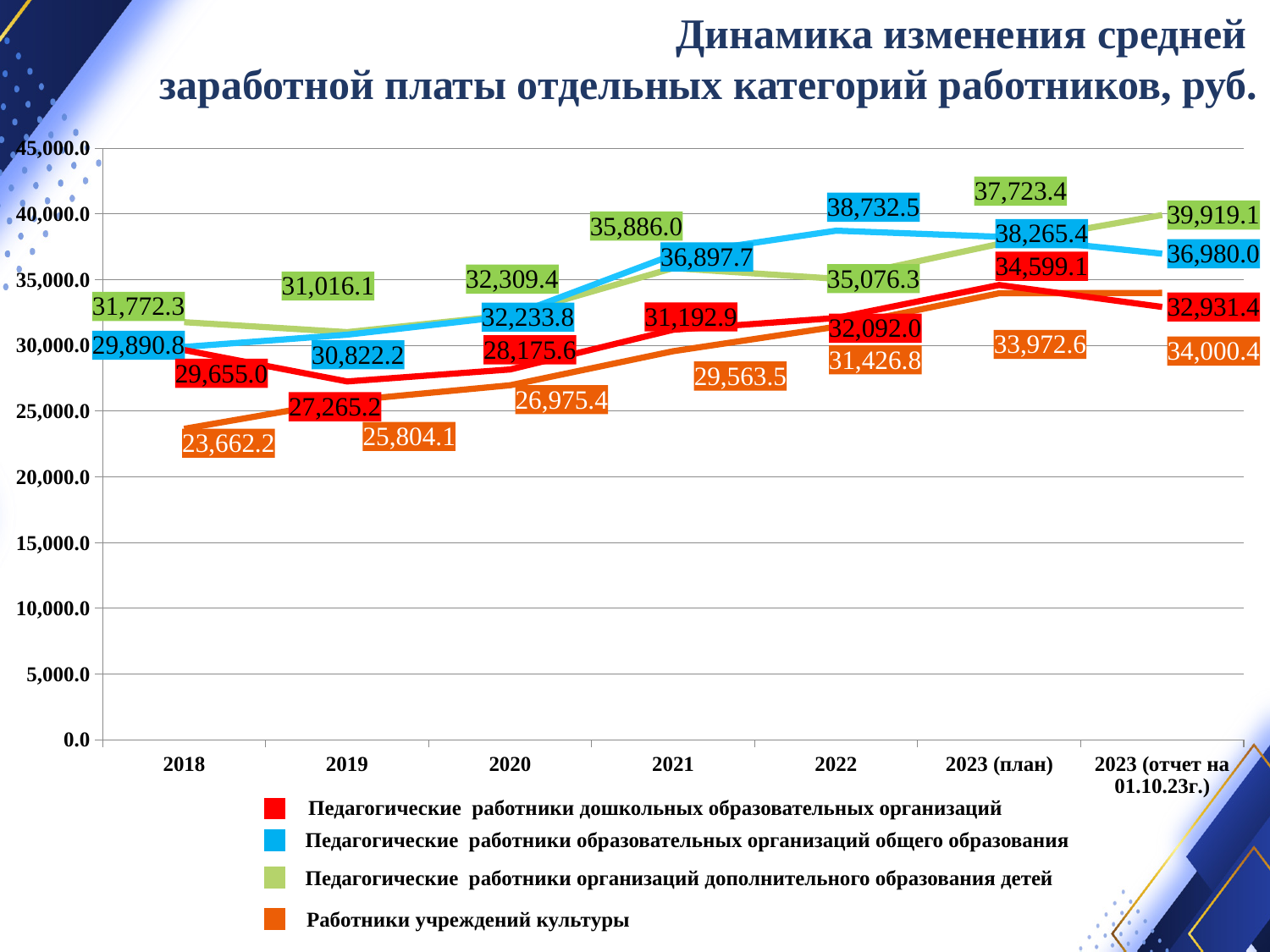
What is the value for Педагогические работники организаций дополнительного образования детей in 2023 (отчет на 01.10.23г.)? 39,919.1 What is the value for Педагогические работники образовательных организаций общего образования in 2022? 38,732.5 How many series does the legend list? 4 How many points are plotted along the x axis? 7 In which year is the value for Работники учреждений культуры lowest? 2018 Does the value for Работники учреждений культуры rise or fall from 2018 to 2022? rise In which year is the value for Педагогические работники образовательных организаций общего образования highest? 2022 What is the value for Педагогические работники дошкольных образовательных организаций in 2021? 31,192.9 What is the value for Работники учреждений культуры in 2018? 23,662.2 In 2022, which is larger: the value for Педагогические работники образовательных организаций общего образования or for Педагогические работники организаций дополнительного образования детей? Педагогические работники образовательных организаций общего образования What is the difference between the 2023 (план) values for Педагогические работники дошкольных образовательных организаций and Работники учреждений культуры? 626.5 What type of chart is shown on the slide? line chart